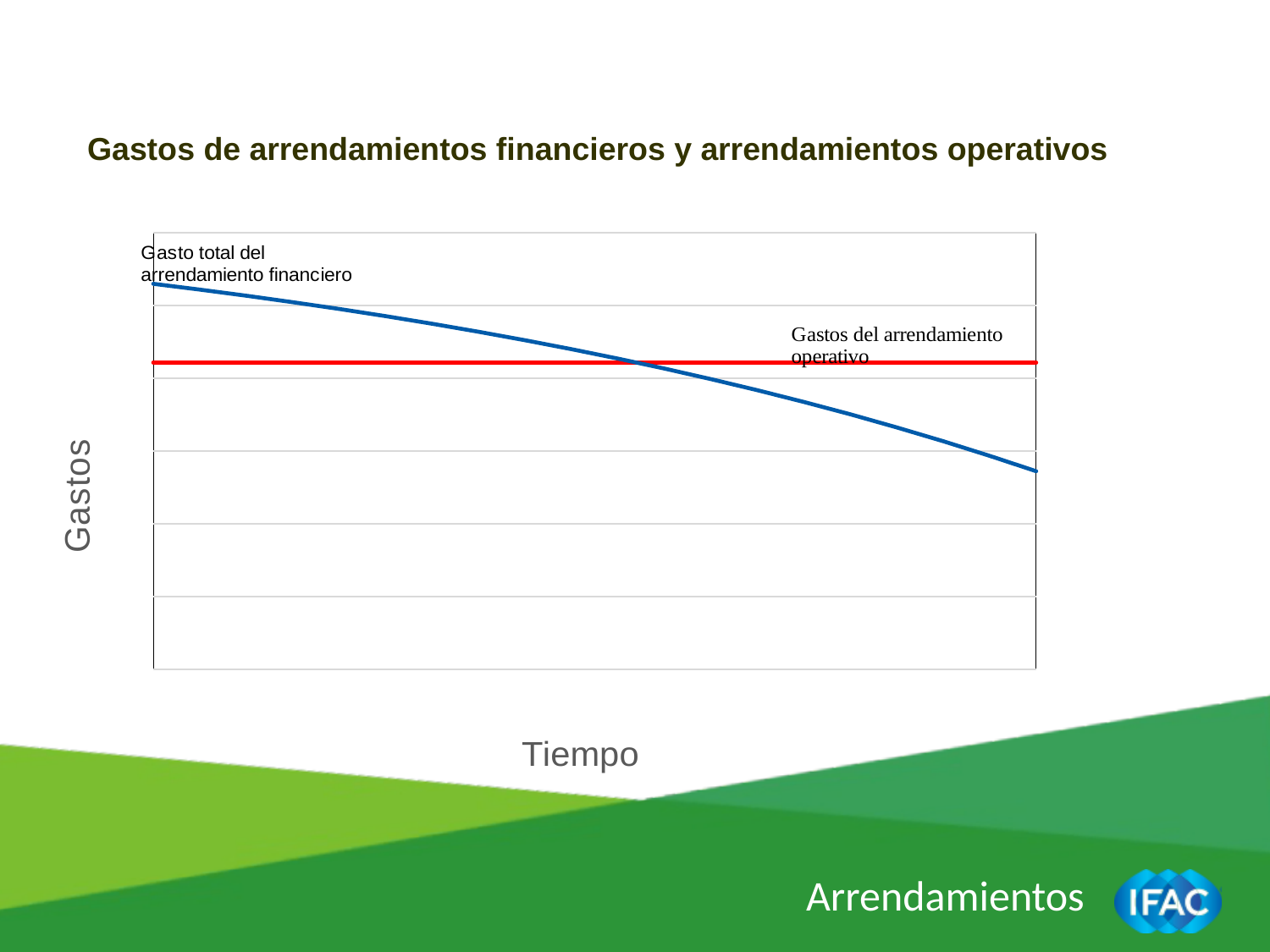
Does the line for 'Gasto total del arrendamiento financiero' rise or fall over time? fall How many lines (series) are plotted on the chart? 2 Which series is drawn as a red line? Gastos del arrendamiento operativo What kind of chart is shown on the slide? line chart Does the line for 'Gastos del arrendamiento operativo' rise, fall, or stay flat over time? stay flat At the start of the time axis, which is higher: 'Gasto total del arrendamiento financiero' or 'Gastos del arrendamiento operativo'? Gasto total del arrendamiento financiero At the end of the time axis, which is higher: 'Gasto total del arrendamiento financiero' or 'Gastos del arrendamiento operativo'? Gastos del arrendamiento operativo What is the title of the chart? Gastos de arrendamientos financieros y arrendamientos operativos What is the label on the vertical axis of the chart? Gastos